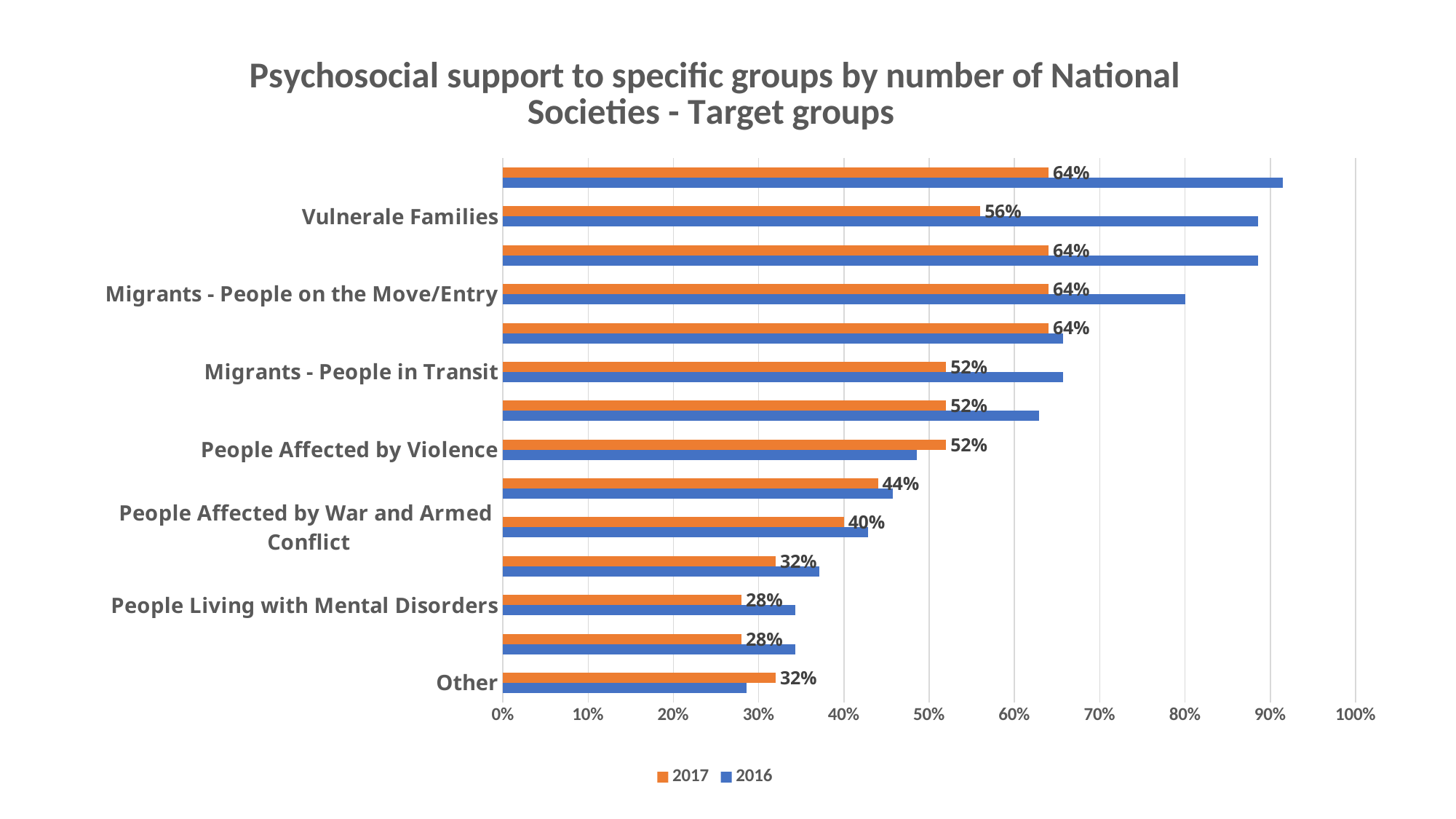
Is the 2016 value for Other greater or less than 30%? less What is the difference between the 2017 values for Migrants - People on the Move/Entry and People Living with Mental Disorders? 36 percentage points What kind of chart is shown on the slide? Bar chart What is the 2017 value for People Living with Mental Disorders? 28% How many series does the legend list? 2 What is the 2017 value for Other? 32% Is the 2016 value for People Affected by Violence greater or less than 50%? less What is the 2017 value for Migrants - People on the Move/Entry? 64% For Other, which year has the larger value, 2017 or 2016? 2017 Is the 2016 value for Vulnerale Families greater or less than 80%? greater What is the 2017 value for People Affected by War and Armed Conflict? 40% What is the 2017 value for Vulnerale Families? 56%